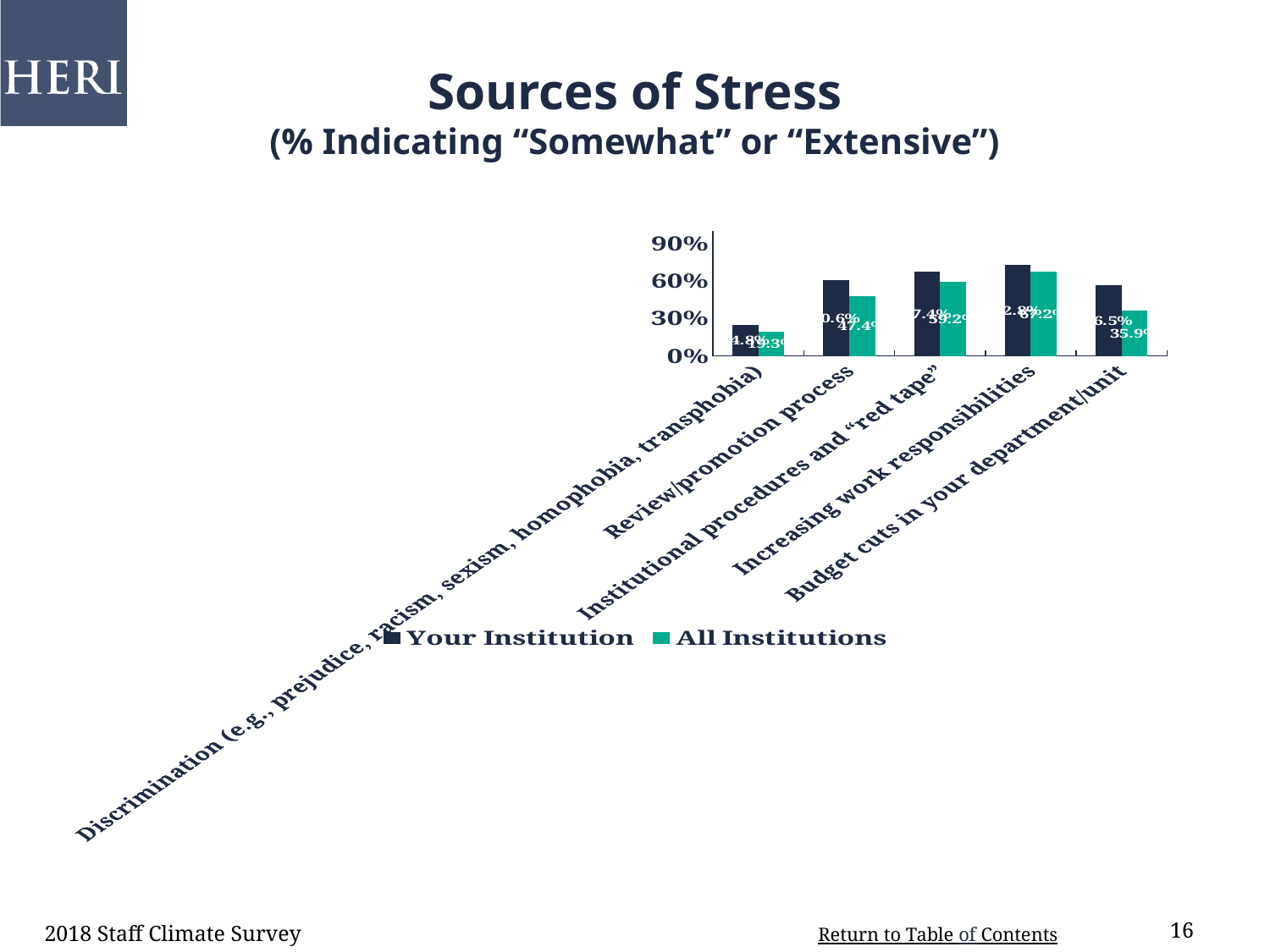
How many series does the legend list? 2 How many sources of stress (categories) are shown on the x axis? 5 For Budget cuts in your department/unit, which series has the larger value, Your Institution or All Institutions? Your Institution What are the two series named in the legend? Your Institution and All Institutions What is the All Institutions value for Institutional procedures and "red tape"? 59.2% What is the All Institutions value for Budget cuts in your department/unit? 35.9% Is the Your Institution value for Discrimination greater or less than 30%? less Which source of stress has the highest value for Your Institution? Increasing work responsibilities Which source of stress has the lowest value for All Institutions? Discrimination (e.g., prejudice, racism, sexism, homophobia, transphobia) What type of chart is shown on the slide? Bar chart What is the All Institutions value for Review/promotion process? 47.4% What is the All Institutions value for Increasing work responsibilities? 67.2%